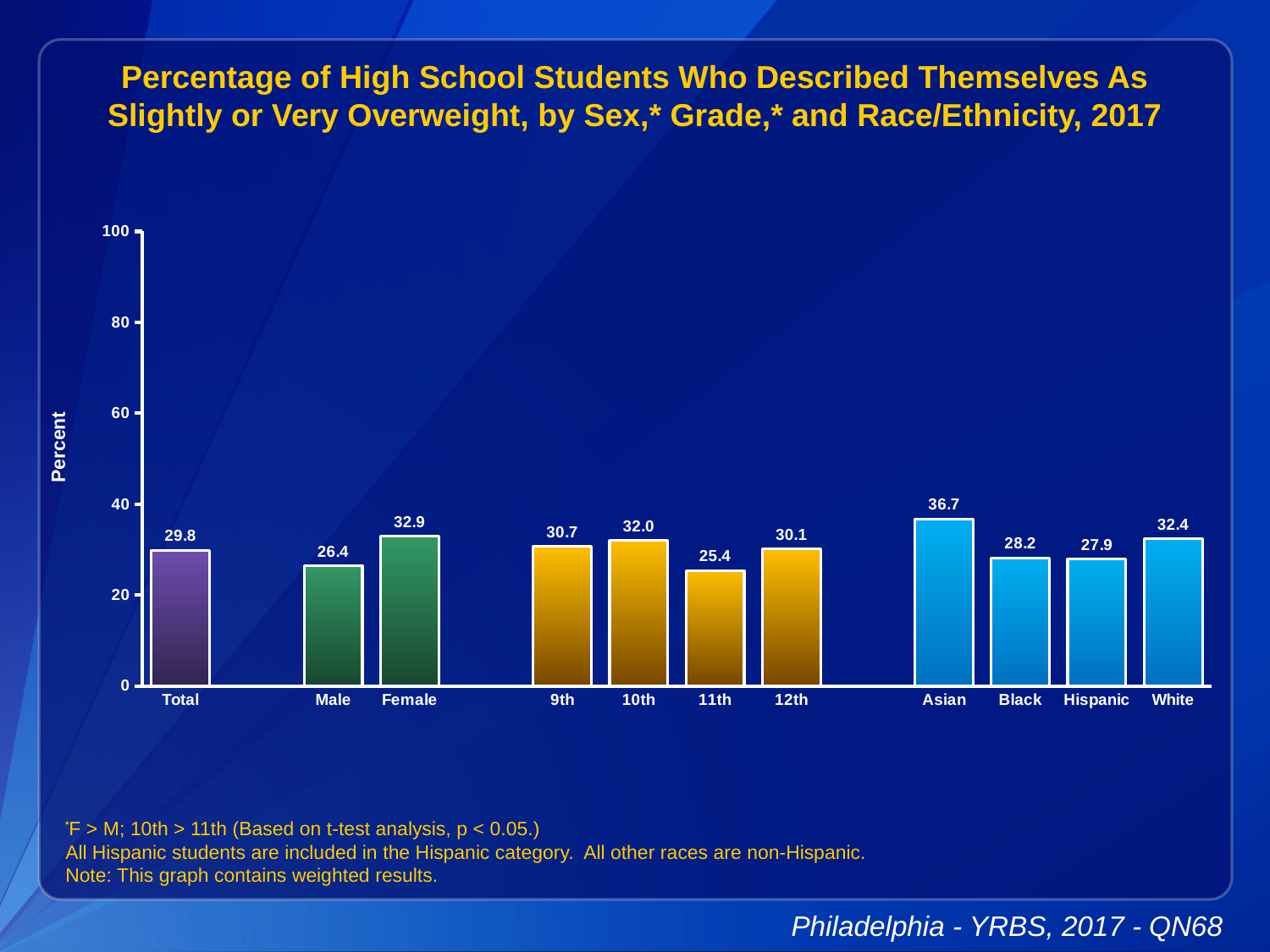
Is the value for Asian greater or less than 40? less Which category has the highest value? Asian What is the value for 11th grade? 25.4 What is the value for Female? 32.9 What is the difference between the Female and Male values? 6.5 What is the label of the y axis? Percent What is the value for Hispanic? 27.9 What kind of chart is shown on the slide? bar chart Which is larger, the value for 10th grade or the value for 12th grade? 10th Which category has the lowest value? 11th How many bars are shown in the chart? 11 What is the value for Total? 29.8